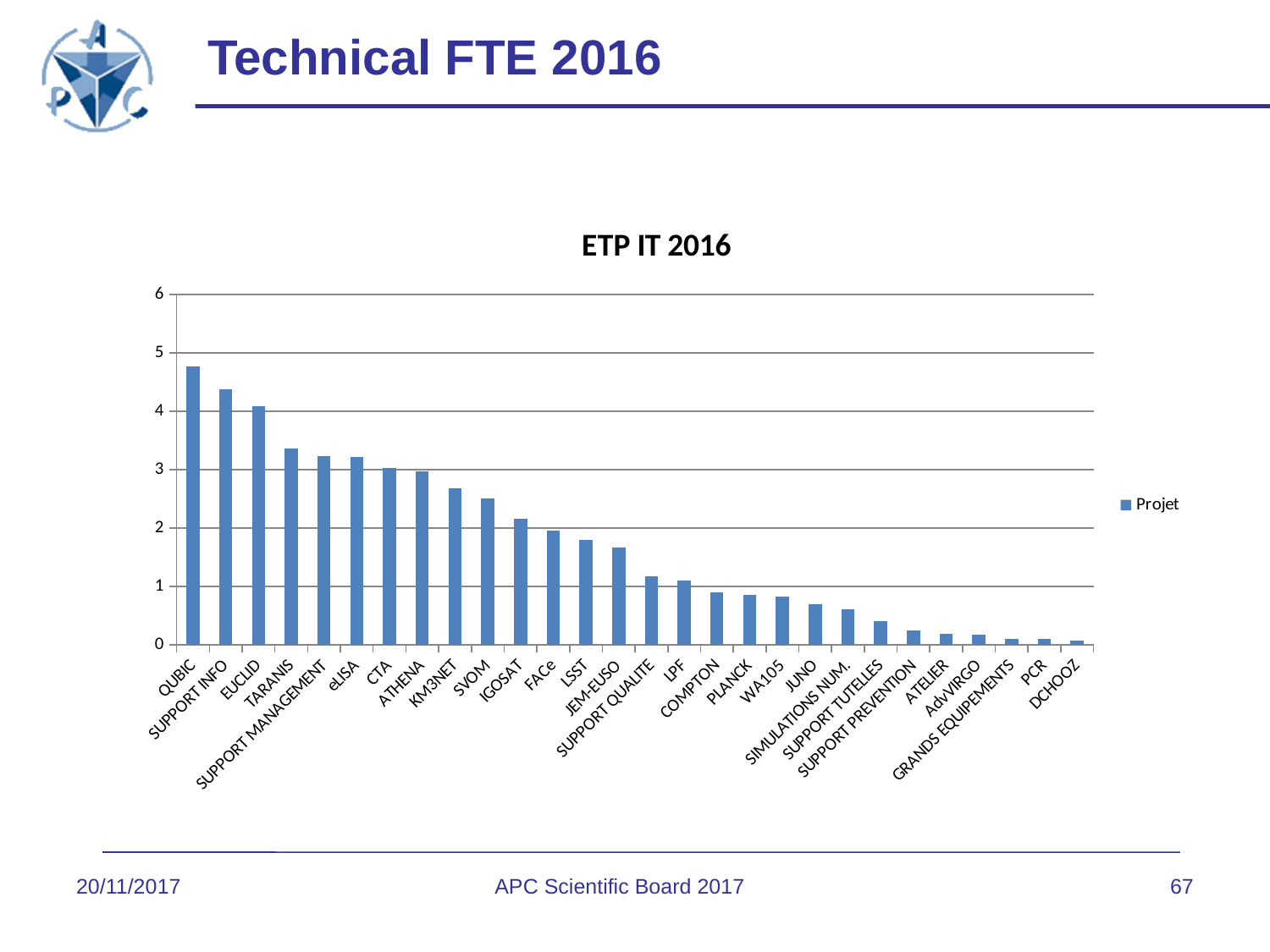
Which category has the highest value? QUBIC Is the value for QUBIC greater or less than 4? greater Which is larger, the value for TARANIS or the value for SVOM? TARANIS Is the value for KM3NET greater or less than 3? less What is the title of the chart? ETP IT 2016 How many series does the legend list? 1 How many categories are shown on the x axis? 28 Is the value for SVOM greater or less than 2? greater Do the values rise or fall from left to right along the x axis? fall What kind of chart is shown on the slide? bar chart